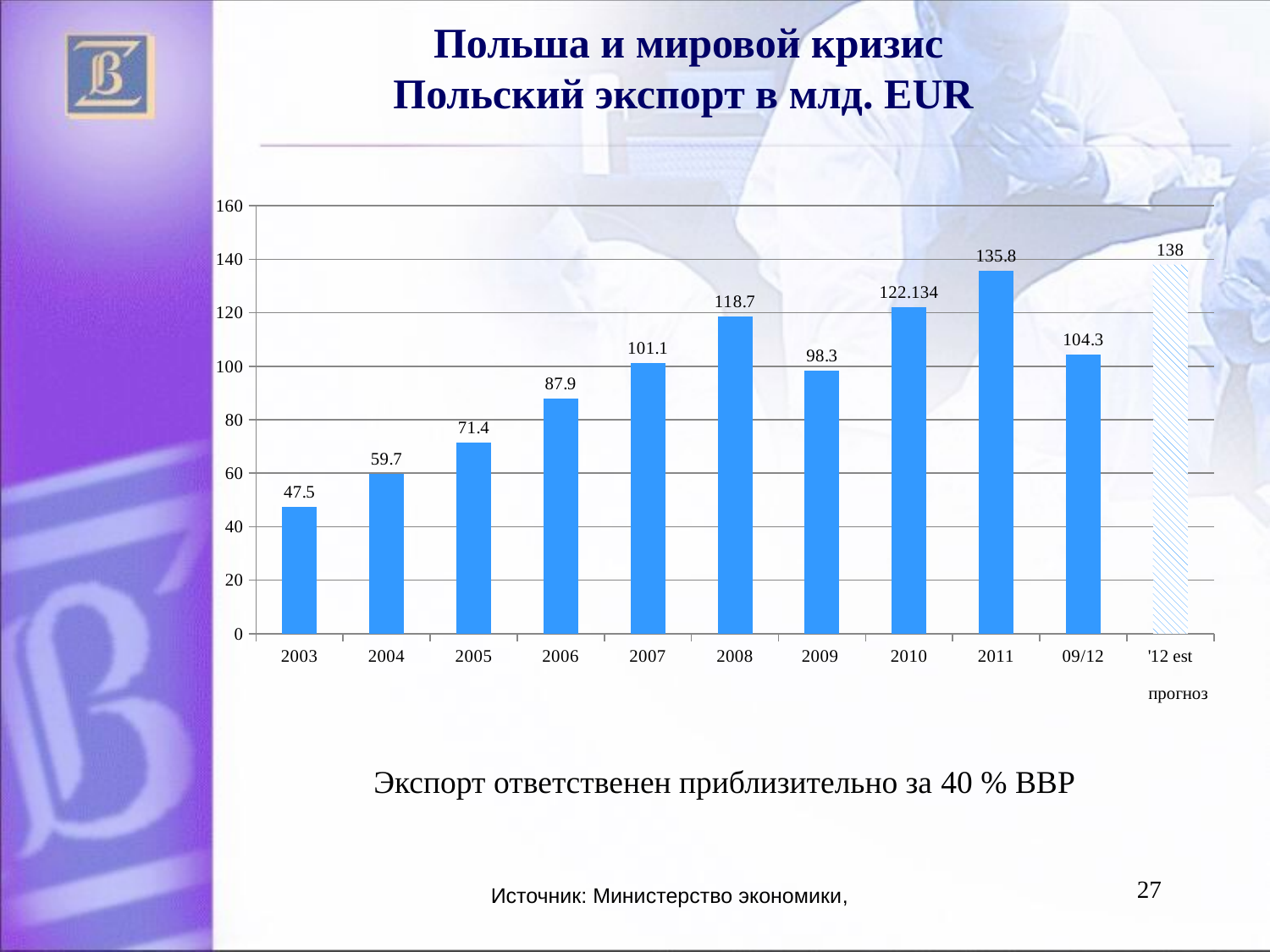
Which category has the lowest value? 2003 What kind of chart is shown on the slide? bar chart What is the value for 2003? 47.5 Do the values rise or fall from 2003 to 2008? rise How many categories are shown on the x axis? 11 What is the value for '12 est? 138 Which is larger, the value for 2007 or the value for 2009? 2007 What is the value for 09/12? 104.3 What is the value for 2010? 122.134 Which category has the highest value? '12 est What is the difference between the values for 2011 and 2010? 13.666 What is the difference between the values for 2008 and 2009? 20.4